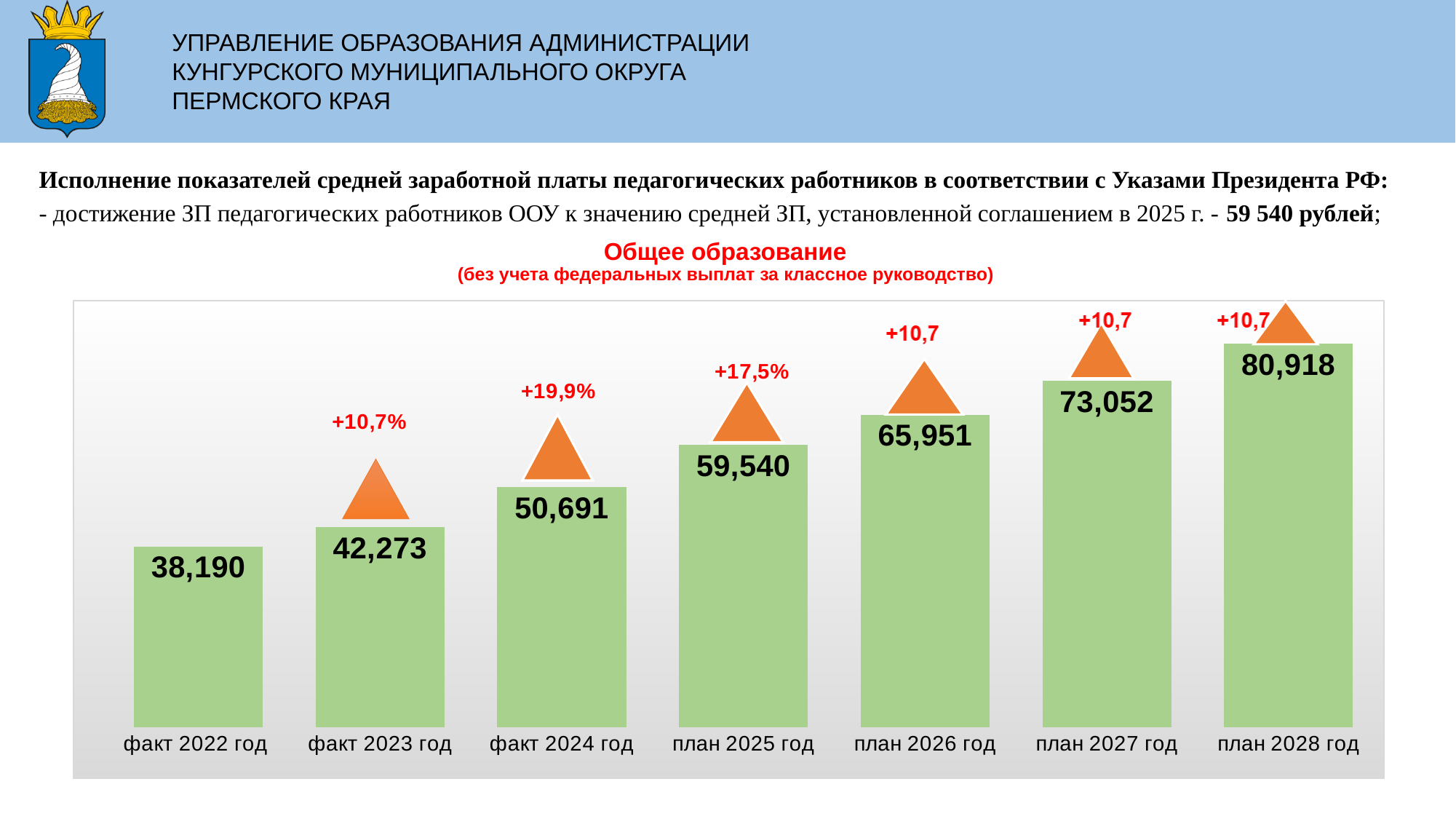
What kind of chart is shown on the slide? bar chart What is the value shown for факт 2022 год? 38,190 What is the value shown for план 2028 год? 80,918 What is the difference between the values for факт 2023 год and факт 2022 год? 4,083 Do the values rise or fall from факт 2022 год to план 2028 год? rise How many bars are shown in the chart? 7 What percentage growth is labelled above the bar for факт 2024 год? +19,9% Which category has the highest value? план 2028 год What is the difference between the values for план 2025 год and факт 2024 год? 8,849 Which category has the lowest value? факт 2022 год Which is larger, the value for план 2026 год or the value for план 2027 год? план 2027 год What is the value shown for план 2025 год? 59,540